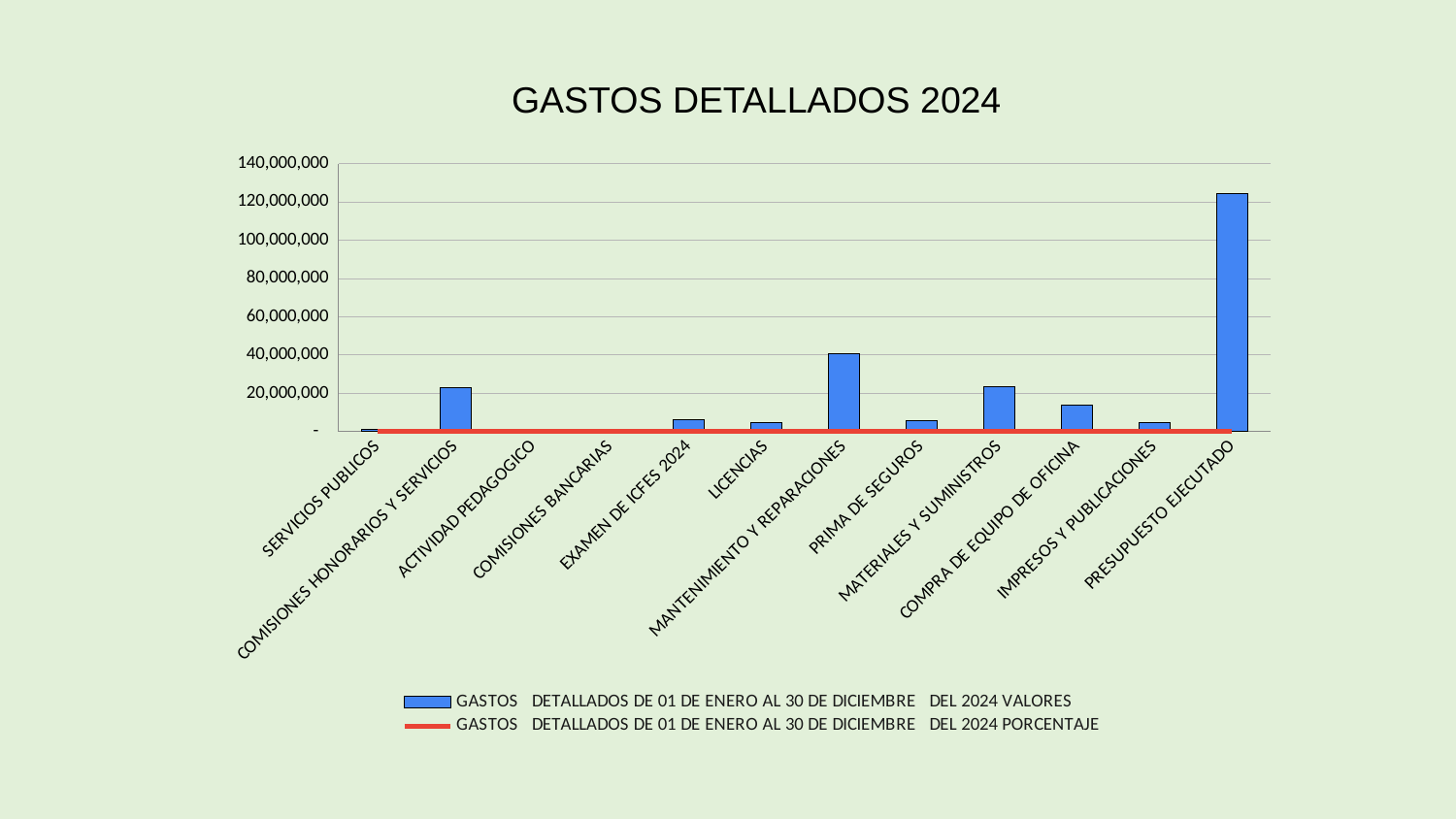
How many series does the legend list? 2 Is the value for LICENCIAS greater or less than 20,000,000? less What kind of chart is shown on the slide? Combination bar and line chart Is the value for MANTENIMIENTO Y REPARACIONES greater or less than 20,000,000? greater Which is larger, the value for MANTENIMIENTO Y REPARACIONES or the value for COMPRA DE EQUIPO DE OFICINA? MANTENIMIENTO Y REPARACIONES What is the title of the chart? GASTOS DETALLADOS 2024 Is the value for COMISIONES HONORARIOS Y SERVICIOS greater or less than 40,000,000? less How many categories are shown on the x axis of the chart? 12 Which category has the highest bar? PRESUPUESTO EJECUTADO What colour is the line series for the PORCENTAJE in the legend? Red